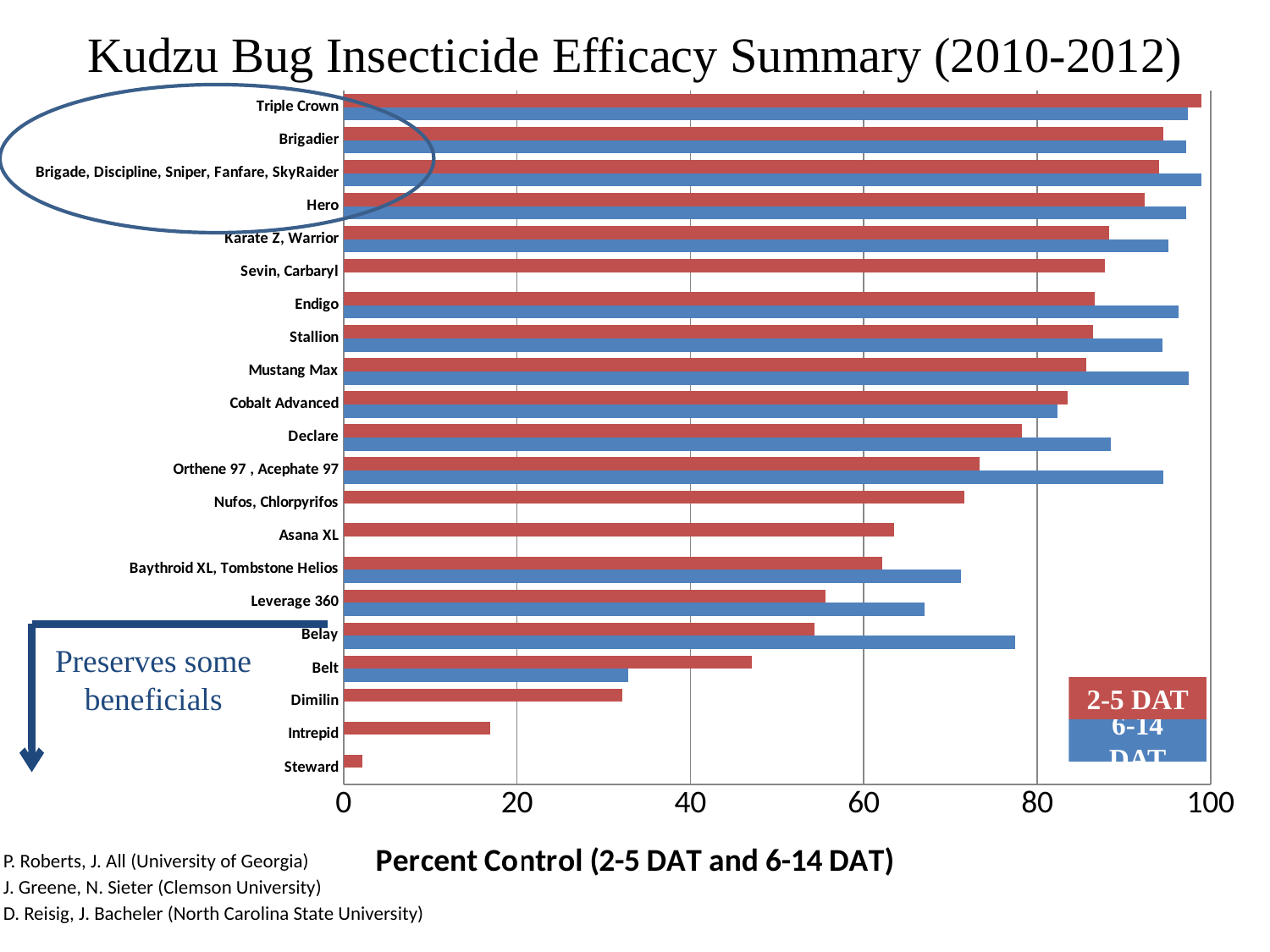
Is the 6-14 DAT value for Leverage 360 greater or less than 60? greater How many series does the legend list? 2 How many insecticide categories are plotted on the chart? 21 For Belt, which series has the larger value, 2-5 DAT or 6-14 DAT? 2-5 DAT What is the title of the horizontal axis? Percent Control (2-5 DAT and 6-14 DAT) Is the 6-14 DAT value for Belay greater or less than 80? less Is the 2-5 DAT value for Intrepid greater or less than 20? less Which insecticide has the highest 2-5 DAT percent control? Triple Crown What kind of chart is shown on the slide? Bar chart Which insecticide has the lowest 2-5 DAT percent control? Steward For Declare, which series has the larger value, 2-5 DAT or 6-14 DAT? 6-14 DAT